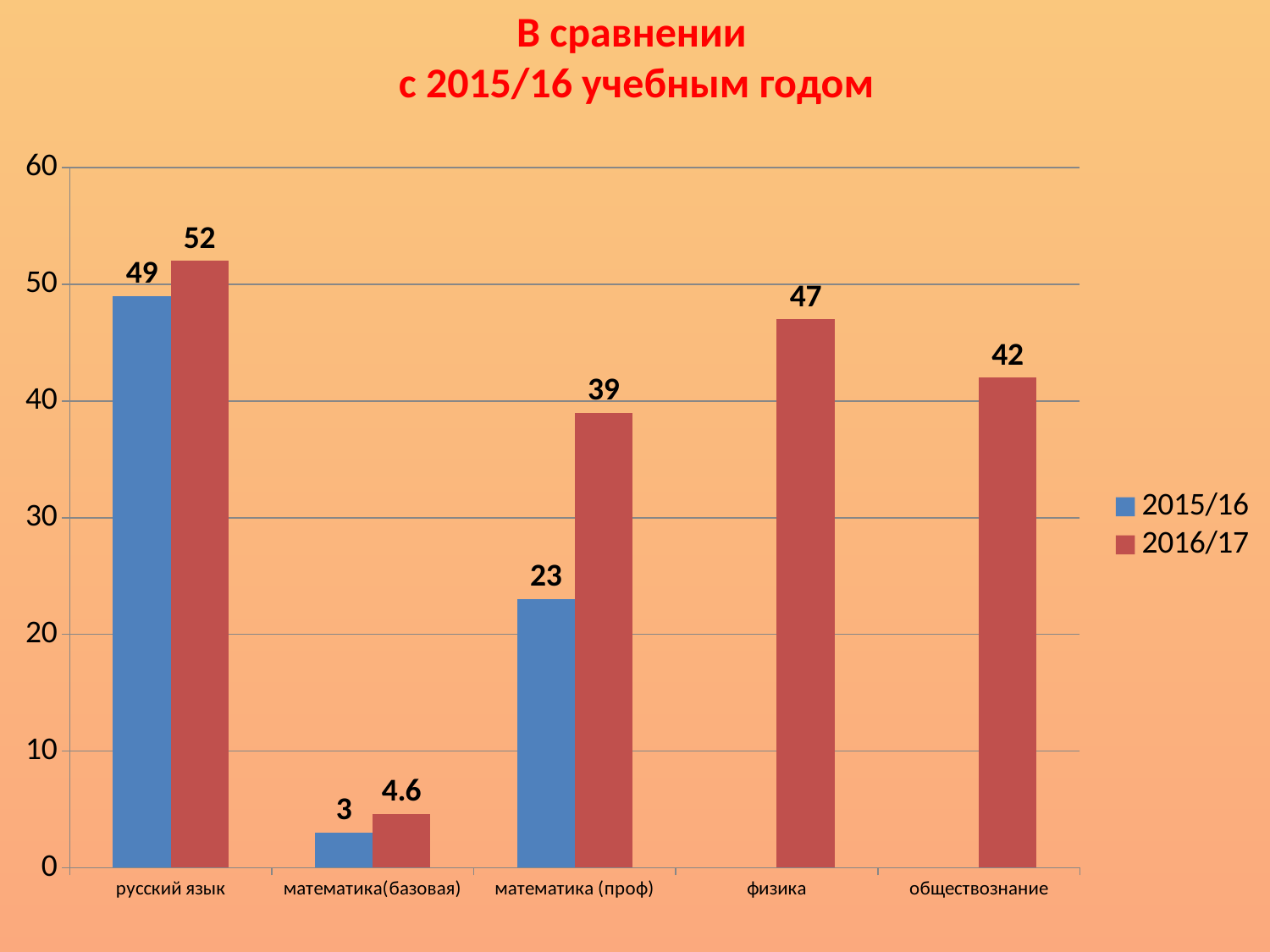
What kind of chart is shown on the slide? bar chart How many categories are shown on the x axis? 5 What is the value for математика (проф) in the 2015/16 series? 23 How many series does the legend list? 2 Which is larger: the 2016/17 value for физика or the 2016/17 value for обществознание? физика What is the value for физика in the 2016/17 series? 47 What is the difference between the 2016/17 and 2015/16 values for математика (проф)? 16 Which category has the lowest value in the 2015/16 series? математика(базовая) Which category has the highest value in the 2016/17 series? русский язык What is the value for русский язык in the 2016/17 series? 52 What is the value for математика(базовая) in the 2016/17 series? 4.6 Is the 2016/17 value for обществознание greater or less than 40? greater